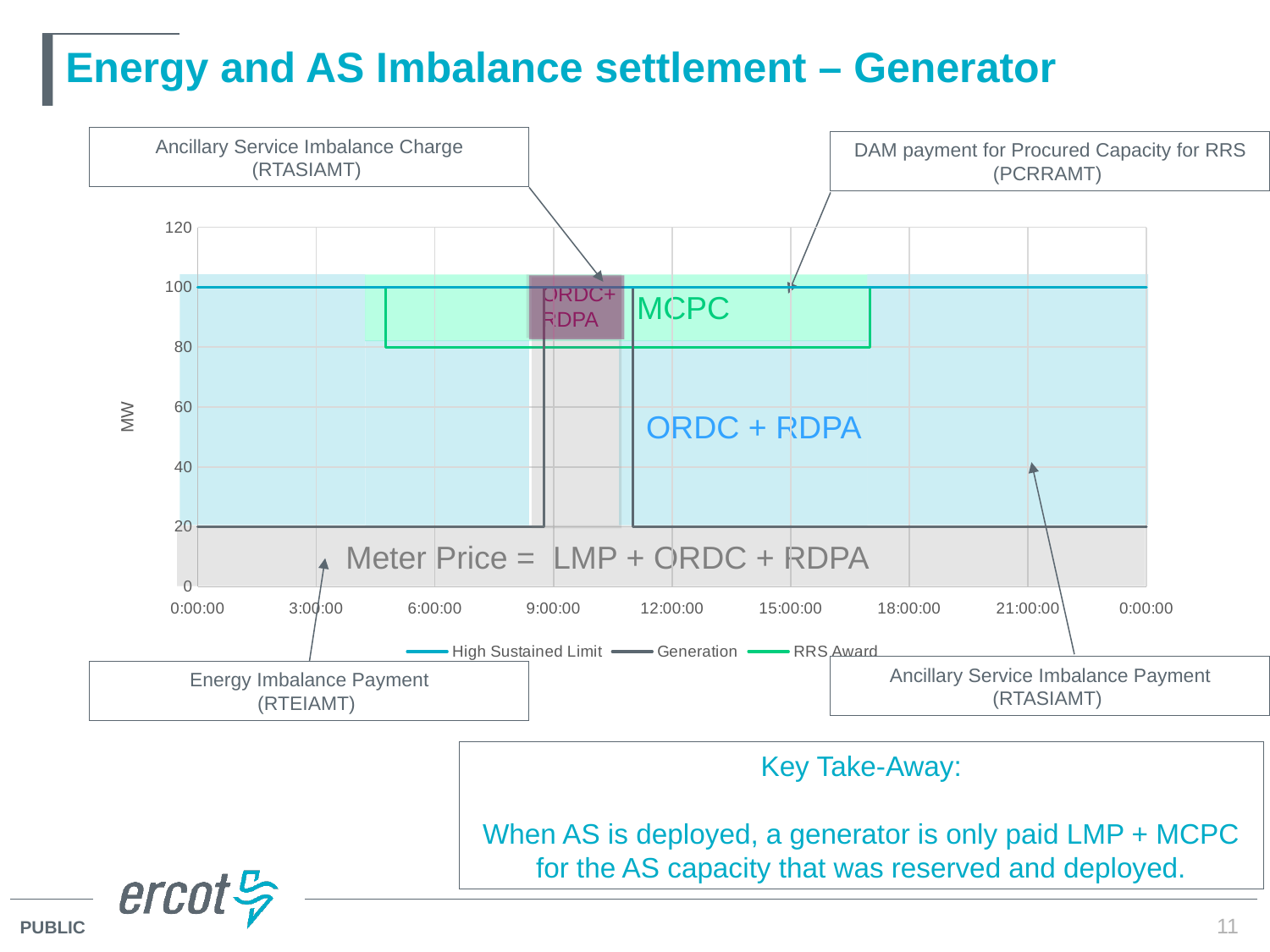
Is the Generation value at 18:00:00 greater or less than 40? less What kind of chart is shown on the slide? line chart At what MW level does the High Sustained Limit line sit? 100 Is the Generation value at 10:00 greater or less than 60? greater What is the difference between the High Sustained Limit and the Generation value at 3:00:00? 80 Which is higher, the High Sustained Limit line or the RRS Award line? High Sustained Limit What is the label on the chart's vertical axis? MW How many series does the chart legend list? 3 What are the three series named in the chart legend? High Sustained Limit, Generation, RRS Award What is the Generation value at 3:00:00? 20 What is the highest value shown on the vertical axis? 120 At what MW level does the RRS Award line sit between about 6:00:00 and 15:00:00? 80